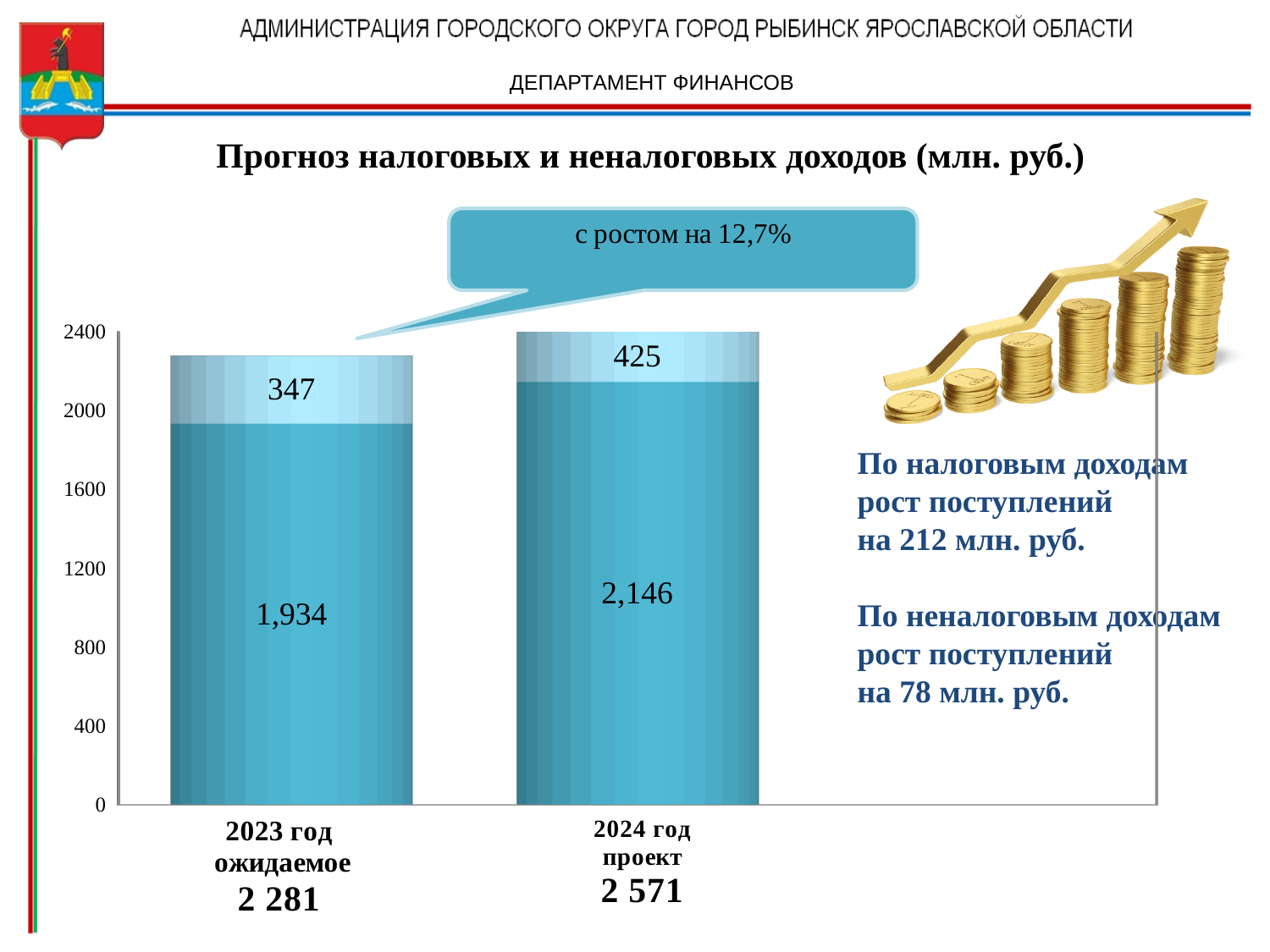
What is the total shown for the 2024 год проект bar? 2 571 What kind of chart is shown on the slide? Stacked bar chart How many categories are shown on the x axis of the chart? 2 What is the total shown for the 2023 год ожидаемое bar? 2 281 What is the value of the upper (light) segment of the bar for 2024 год проект? 425 What is the difference between the upper (light) segments of the 2024 год проект and 2023 год ожидаемое bars? 78 What is the value of the lower (dark) segment of the bar for 2024 год проект? 2,146 By how much does the lower (dark) segment for 2024 год проект exceed the lower segment for 2023 год ожидаемое? 212 Which bar has the larger total, 2023 год ожидаемое or 2024 год проект? 2024 год проект What is the value of the upper (light) segment of the bar for 2023 год ожидаемое? 347 Is the lower (dark) segment of the 2024 год проект bar greater or less than 2000? greater What is the value of the lower (dark) segment of the bar for 2023 год ожидаемое? 1,934